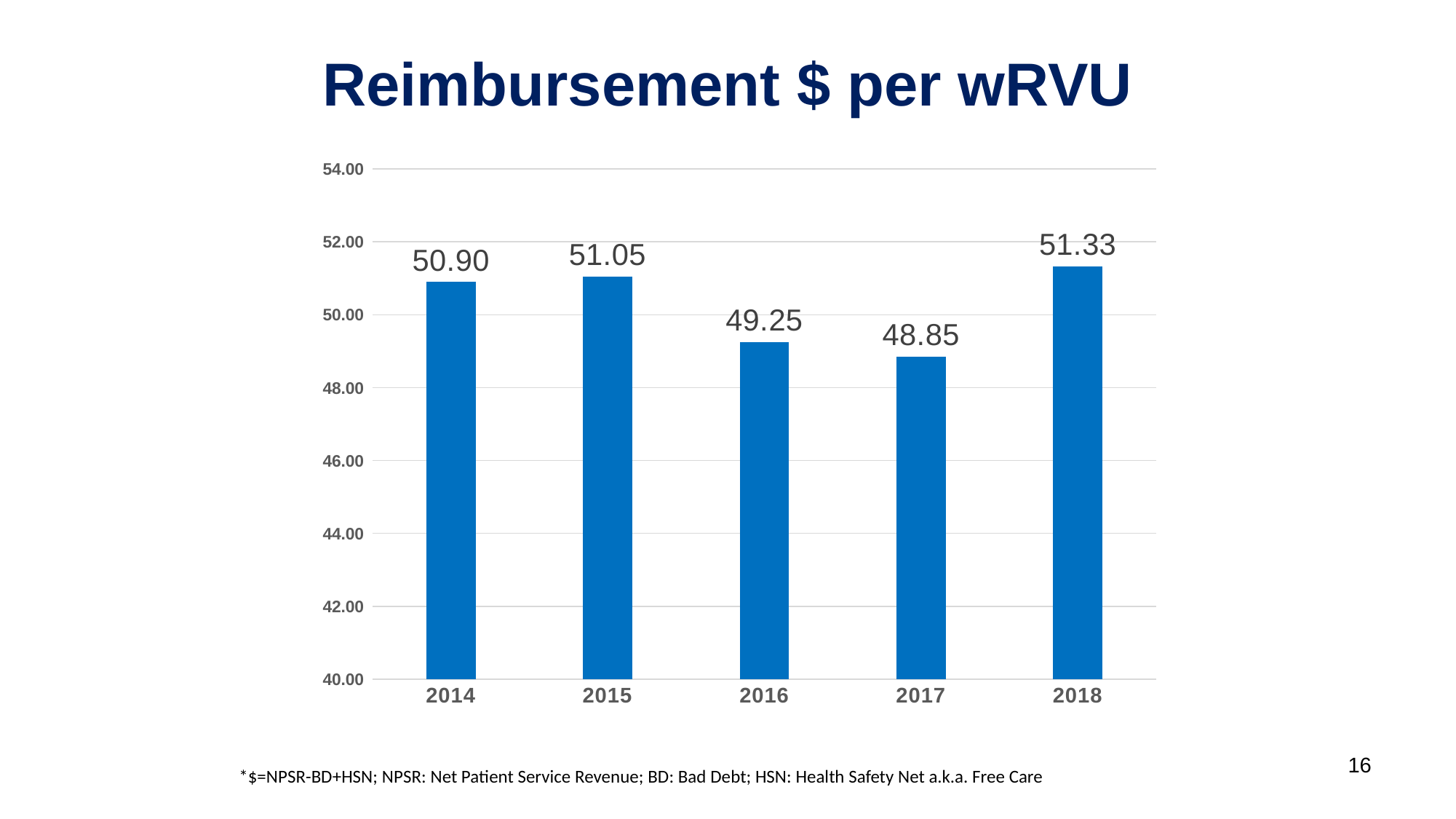
What kind of chart is shown on the slide? bar chart Which year has the lowest reimbursement $ per wRVU? 2017 What is the title of the chart? Reimbursement $ per wRVU What is the reimbursement $ per wRVU for 2018? 51.33 What is the reimbursement $ per wRVU for 2017? 48.85 How many years are shown on the chart? 5 Which year has the highest reimbursement $ per wRVU? 2018 What is the difference between the 2018 and 2017 values? 2.48 Which is larger, the value for 2015 or the value for 2016? 2015 What is the difference between the 2015 and 2016 values? 1.80 What is the reimbursement $ per wRVU for 2014? 50.90 Is the value for 2016 greater or less than 50.00? less